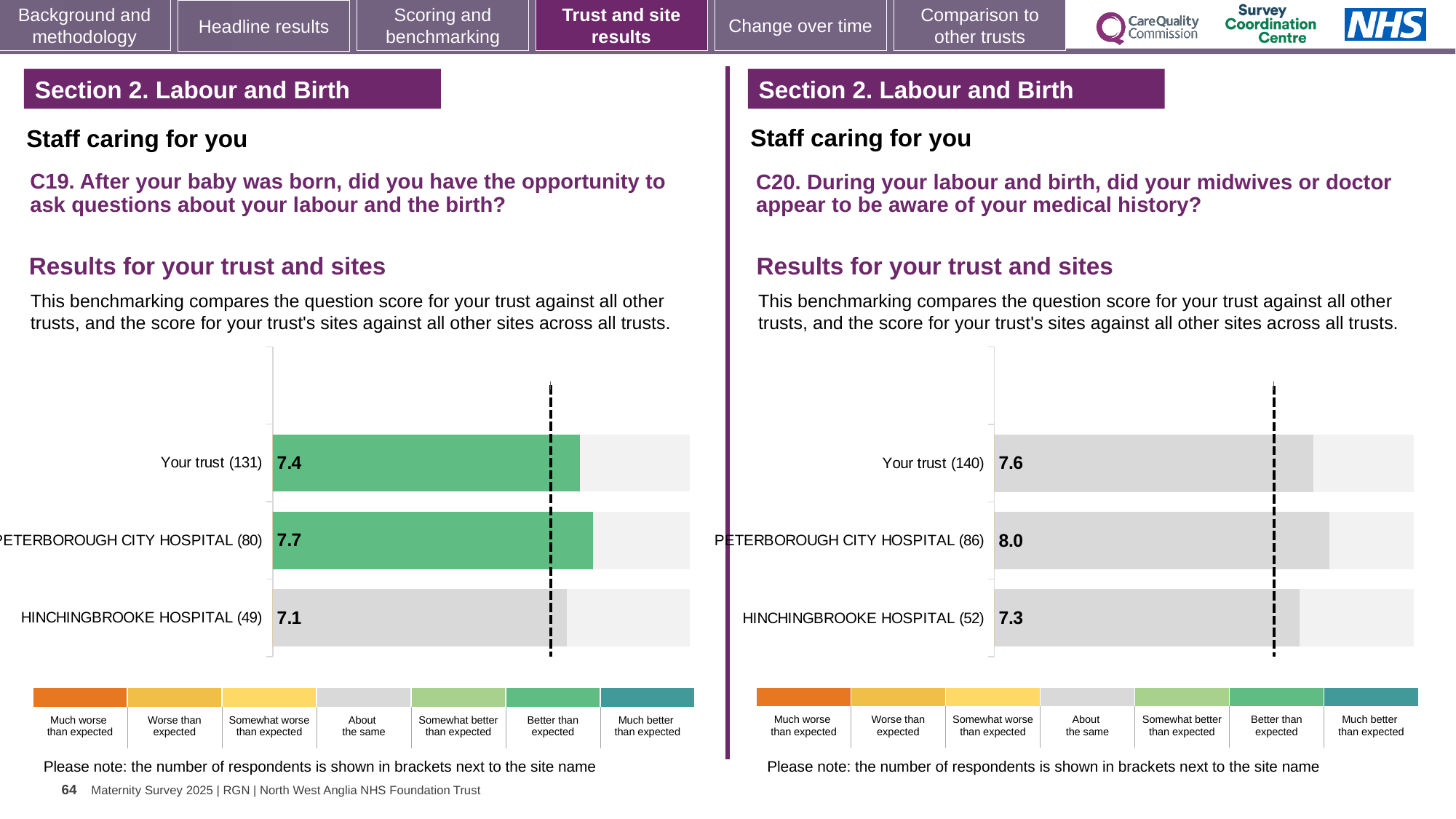
In the C19 chart on the left, which site or trust has the lowest score? HINCHINGBROOKE HOSPITAL In the C20 chart on the right, what is the difference between the scores for PETERBOROUGH CITY HOSPITAL and Your trust? 0.4 In the C19 chart on the left, what is the difference between the scores for PETERBOROUGH CITY HOSPITAL and HINCHINGBROOKE HOSPITAL? 0.6 In the C20 chart on the right, which site or trust has the highest score? PETERBOROUGH CITY HOSPITAL How many bars are plotted in the C20 chart on the right? 3 In the C19 chart on the left, what is the score for PETERBOROUGH CITY HOSPITAL? 7.7 In the C20 chart on the right, which has the larger score, Your trust or HINCHINGBROOKE HOSPITAL? Your trust In the C19 chart on the left, which benchmark category does the green colour of the Your trust bar represent according to the legend? Better than expected In the C19 chart on the left, what is the score for Your trust? 7.4 In the C19 chart on the left, how many respondents are shown in brackets for Your trust? 131 What type of chart is used in the C19 chart on the left? Bar chart In the C20 chart on the right, what is the score for HINCHINGBROOKE HOSPITAL? 7.3